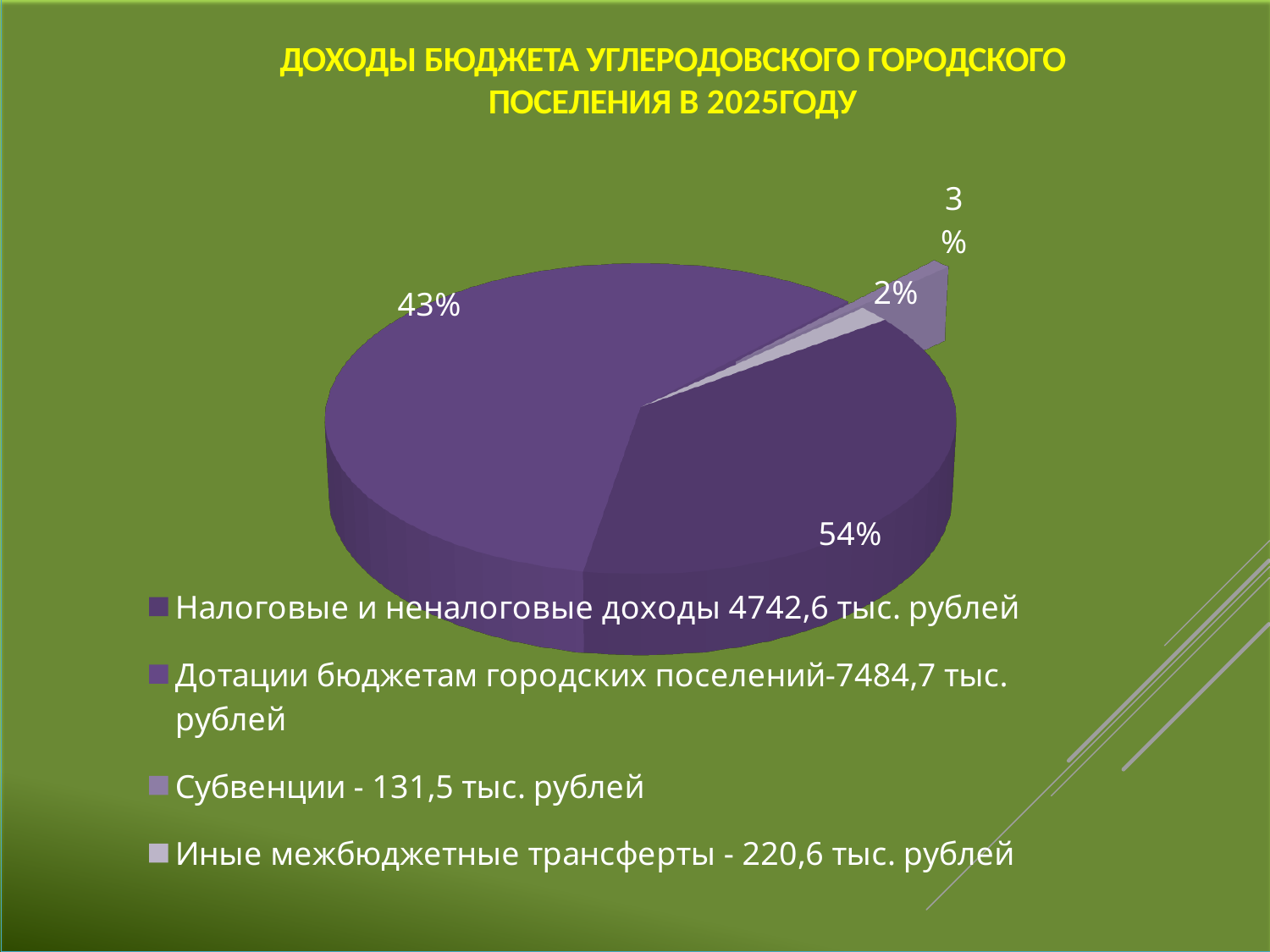
According to the legend, which is larger: Дотации бюджетам городских поселений or Налоговые и неналоговые доходы? Дотации бюджетам городских поселений How many entries does the legend list? 4 What amount is given in the legend for Дотации бюджетам городских поселений? 7484,7 тыс. рублей What amount is given in the legend for Субвенции? 131,5 тыс. рублей What amount is given in the legend for Иные межбюджетные трансферты? 220,6 тыс. рублей What kind of chart is shown on the slide? pie chart What is the largest percentage shown on the pie chart? 54% How many slices does the pie chart have? 4 What is the difference in percentage points between the two largest slices (54% and 43%)? 11 Which year does the chart title refer to? 2025 What amount is given in the legend for Налоговые и неналоговые доходы? 4742,6 тыс. рублей What is the smallest percentage shown on the pie chart? 2%